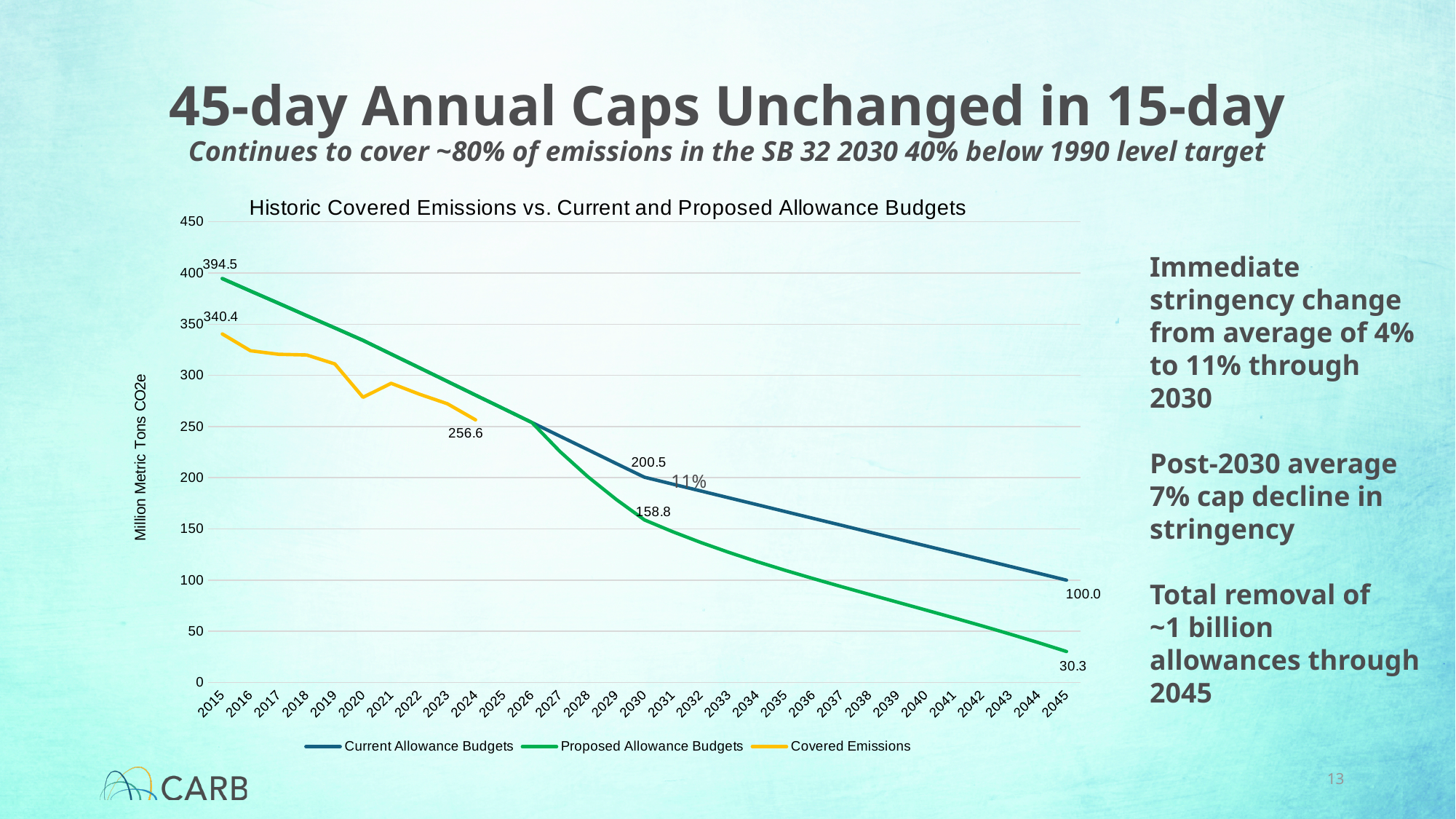
What is the value of Proposed Allowance Budgets in 2045? 30.3 How many series does the legend list? 3 What is the difference between Current Allowance Budgets and Proposed Allowance Budgets in 2045? 69.7 Is the value for Covered Emissions in 2020 greater or less than 300? less In 2045, which series is higher: Current Allowance Budgets or Proposed Allowance Budgets? Current Allowance Budgets What kind of chart is shown on the slide? Line chart What is the value of Covered Emissions in 2015? 340.4 What is the difference between Current Allowance Budgets and Proposed Allowance Budgets in 2030? 41.7 What is the value of Current Allowance Budgets in 2030? 200.5 What is the value of Current Allowance Budgets in 2045? 100.0 What is the value of Covered Emissions in 2024? 256.6 What is the value of Proposed Allowance Budgets in 2030? 158.8